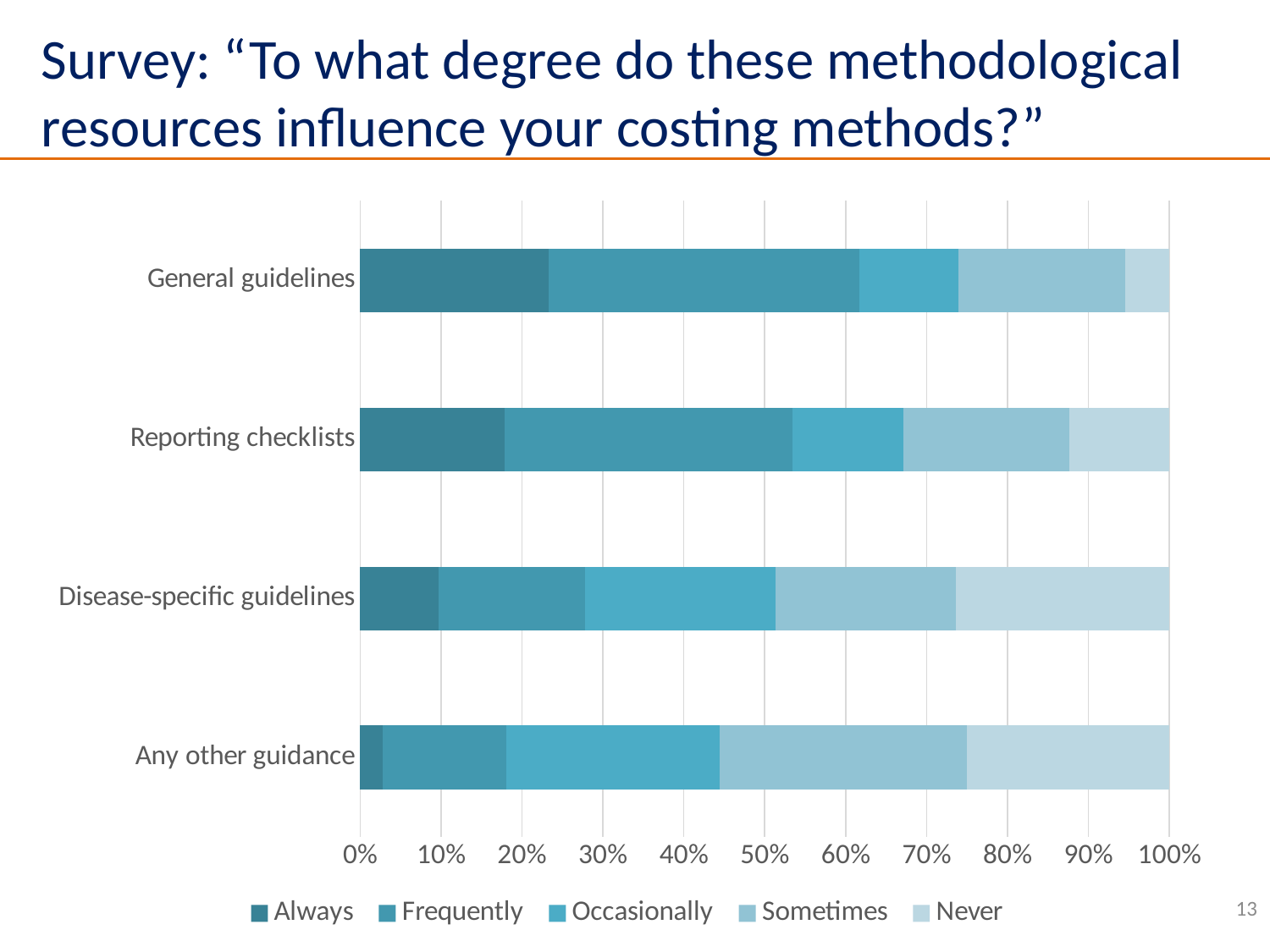
What total does each stacked bar reach on the x axis? 100% Which category has the largest 'Always' segment? General guidelines Is the 'Never' segment larger for Disease-specific guidelines or for General guidelines? Disease-specific guidelines Is the 'Always' segment larger for General guidelines or for Reporting checklists? General guidelines What are the legend entries, in order from left to right? Always, Frequently, Occasionally, Sometimes, Never How many series does the legend list? 5 Is the 'Always' value for Any other guidance greater or less than 10%? less How many categories (resource types) are plotted on the chart? 4 Which category is listed at the top of the chart? General guidelines Is the 'Always' value for General guidelines greater or less than 20%? greater Which category has the smallest 'Always' segment? Any other guidance What kind of chart is shown on the slide? Stacked bar chart